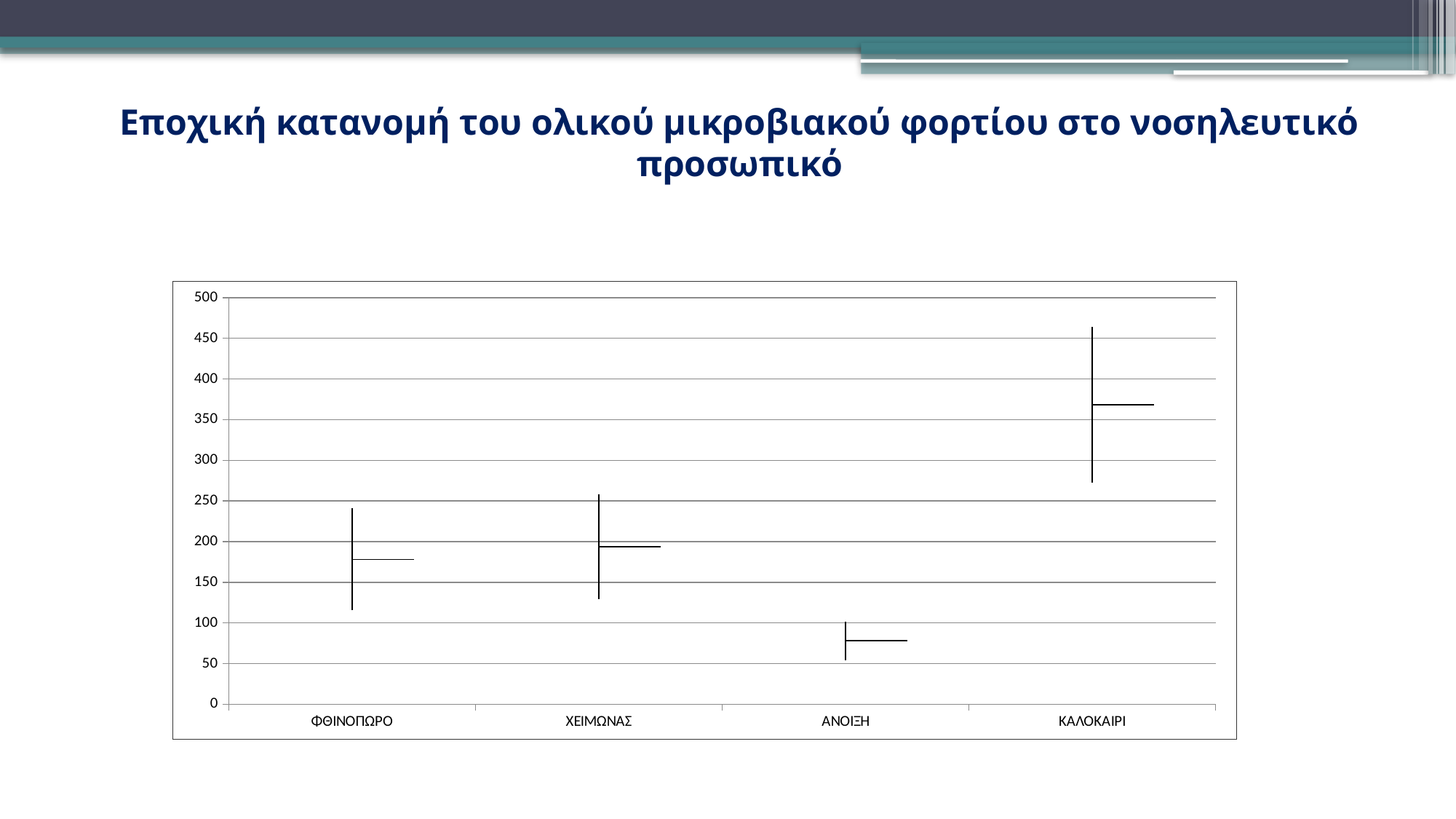
How many categories are shown on the x axis of the chart? 4 Is the top of the vertical line for ΚΑΛΟΚΑΙΡΙ greater or less than 400? greater Which has the larger horizontal marker value, ΚΑΛΟΚΑΙΡΙ or ΑΝΟΙΞΗ? ΚΑΛΟΚΑΙΡΙ Which has the larger horizontal marker value, ΦΘΙΝΟΠΩΡΟ or ΑΝΟΙΞΗ? ΦΘΙΝΟΠΩΡΟ Is the horizontal marker value for ΚΑΛΟΚΑΙΡΙ greater or less than 300? greater Which category has the highest values on the chart? ΚΑΛΟΚΑΙΡΙ Is the horizontal marker value for ΑΝΟΙΞΗ greater or less than 100? less Which category has the lowest values on the chart? ΑΝΟΙΞΗ What is the title of the slide containing the chart? Εποχική κατανομή του ολικού μικροβιακού φορτίου στο νοσηλευτικό προσωπικό What is the maximum value shown on the vertical axis of the chart? 500